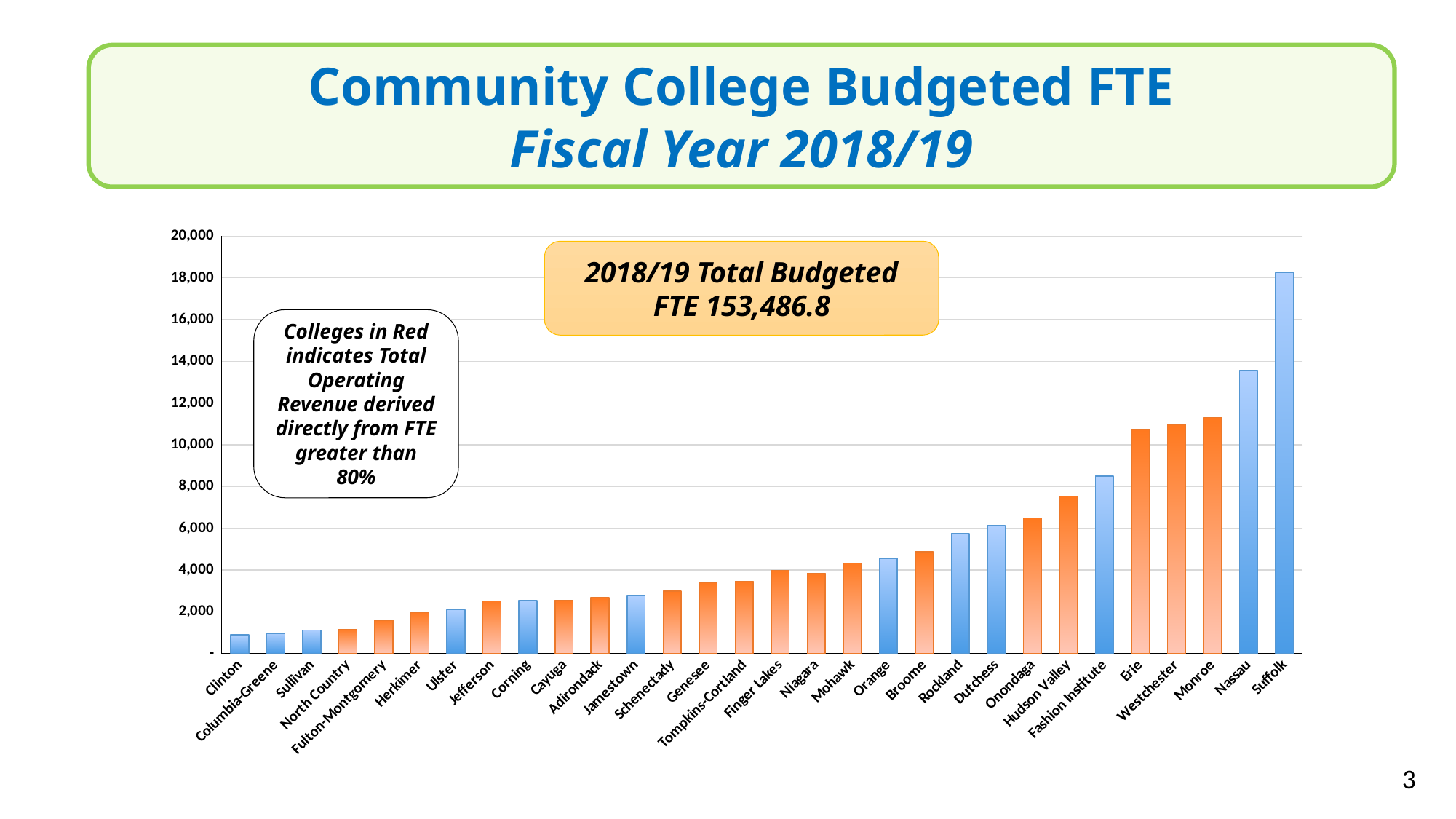
Is the value for Hudson Valley greater or less than 8,000? less Is the value for Monroe greater or less than 10,000? greater Is the value for Clinton greater or less than 2,000? less Do the bar values generally rise or fall from left to right along the x axis? rise Which college has the highest budgeted FTE in the chart? Suffolk Which is larger, the value for Erie or the value for Fashion Institute? Erie Which is larger, the value for Nassau or the value for Monroe? Nassau What is the 2018/19 total budgeted FTE stated on the slide? 153,486.8 How many colleges are shown on the x axis of the chart? 30 What kind of chart is shown on the slide? bar chart